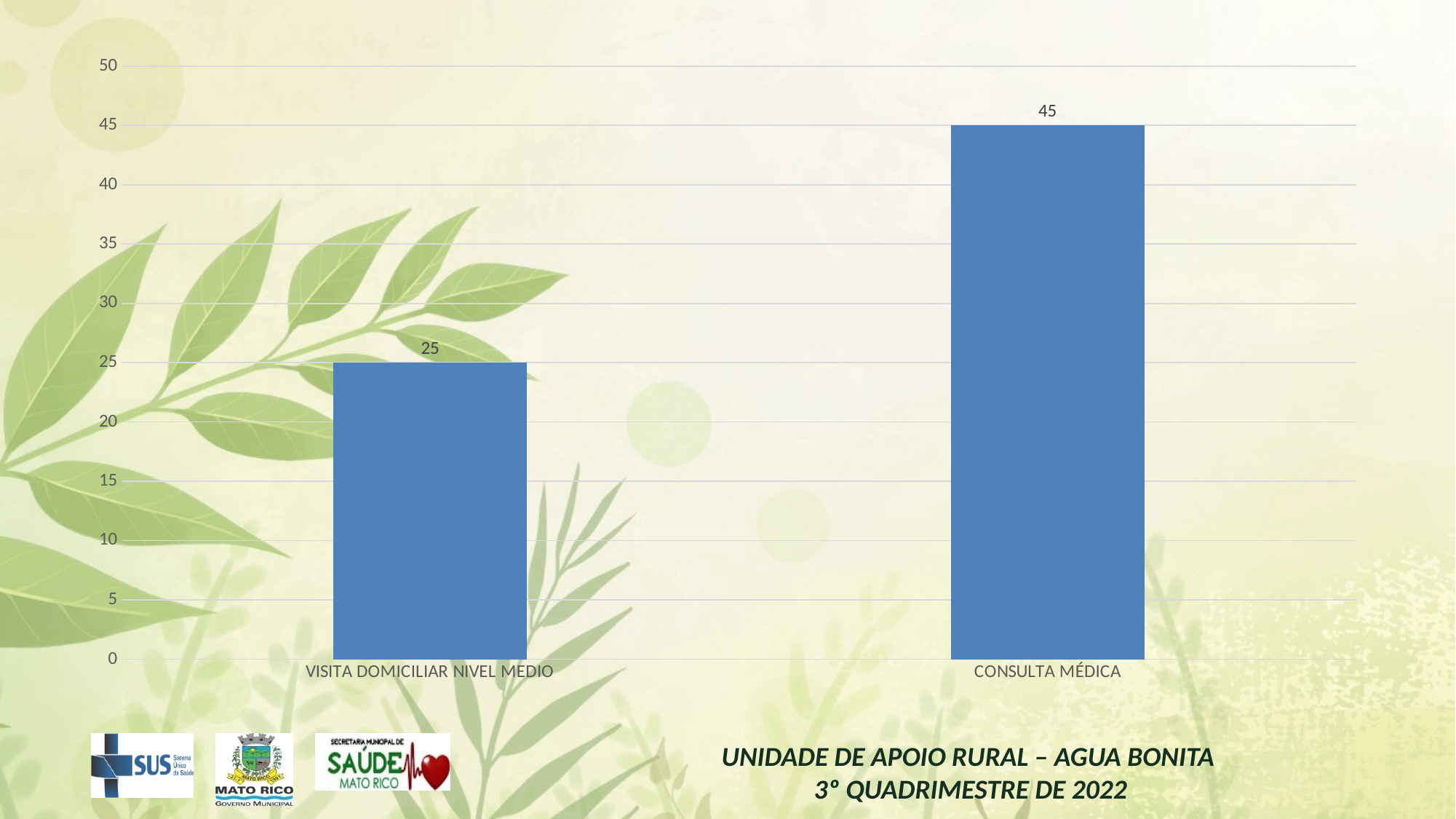
Which category has the highest value? CONSULTA MÉDICA What kind of chart is shown on the slide? bar chart Is the value for CONSULTA MÉDICA greater or less than 40? greater What is the value for CONSULTA MÉDICA? 45 Which category has the lowest value? VISITA DOMICILIAR NIVEL MEDIO Is the value for VISITA DOMICILIAR NIVEL MEDIO greater or less than 30? less Which is larger, the value for VISITA DOMICILIAR NIVEL MEDIO or the value for CONSULTA MÉDICA? CONSULTA MÉDICA How many categories are shown in the chart? 2 What is the value for VISITA DOMICILIAR NIVEL MEDIO? 25 What colour are the bars in the chart? blue What is the highest value shown on the vertical axis? 50 What is the difference between the values for CONSULTA MÉDICA and VISITA DOMICILIAR NIVEL MEDIO? 20